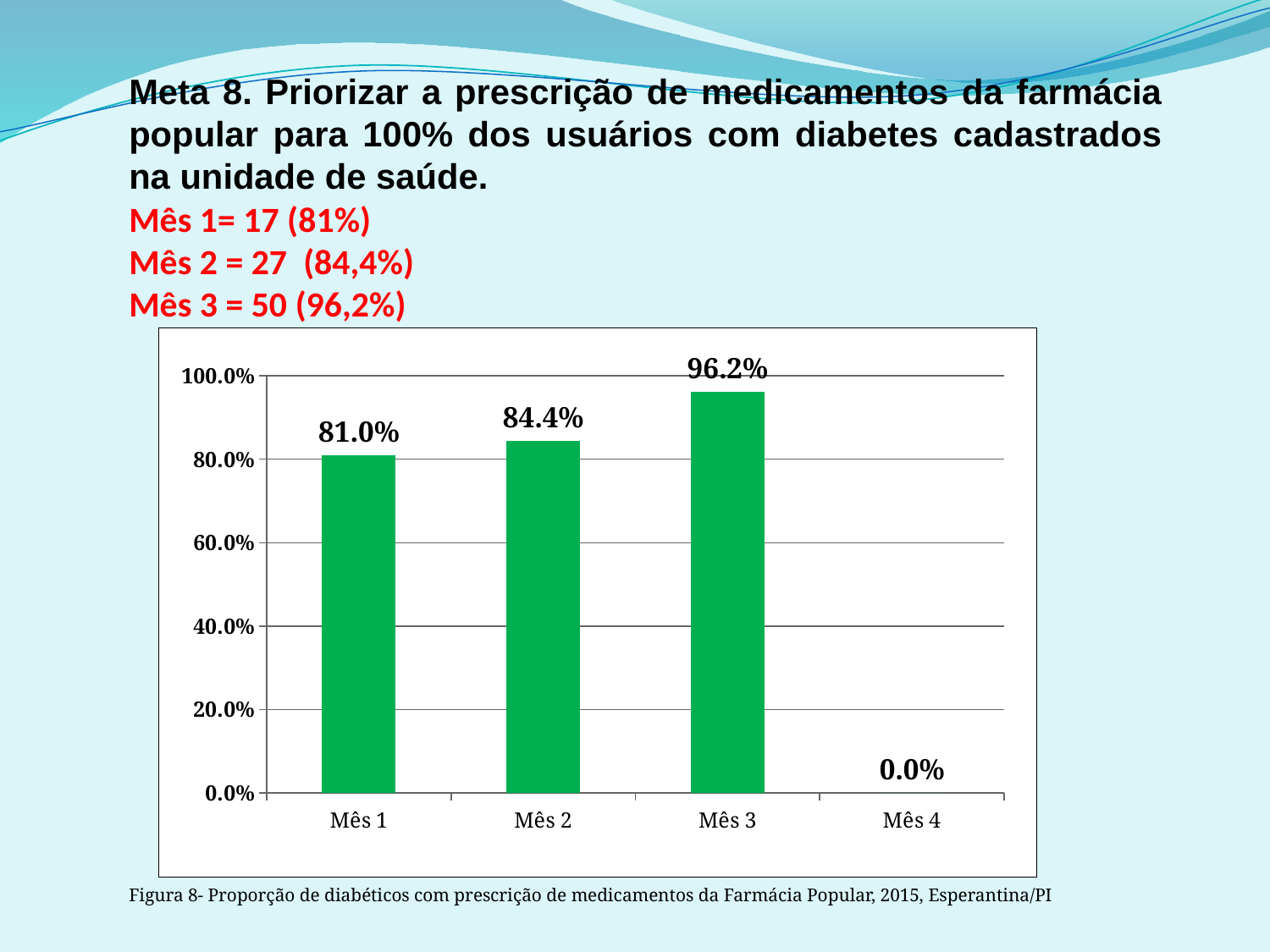
What is the value for Mês 3? 96.2% How many months are shown on the x axis? 4 Which month has the lowest value? Mês 4 What is the difference between the values for Mês 3 and Mês 1? 15.2% What is the value for Mês 4? 0.0% Which month has the highest value? Mês 3 Is the value for Mês 3 greater or less than 80.0%? greater What is the value for Mês 1? 81.0% Do the values rise or fall from Mês 1 to Mês 3? rise What kind of chart is this? bar chart Which is larger, the value for Mês 2 or the value for Mês 1? Mês 2 What is the value for Mês 2? 84.4%